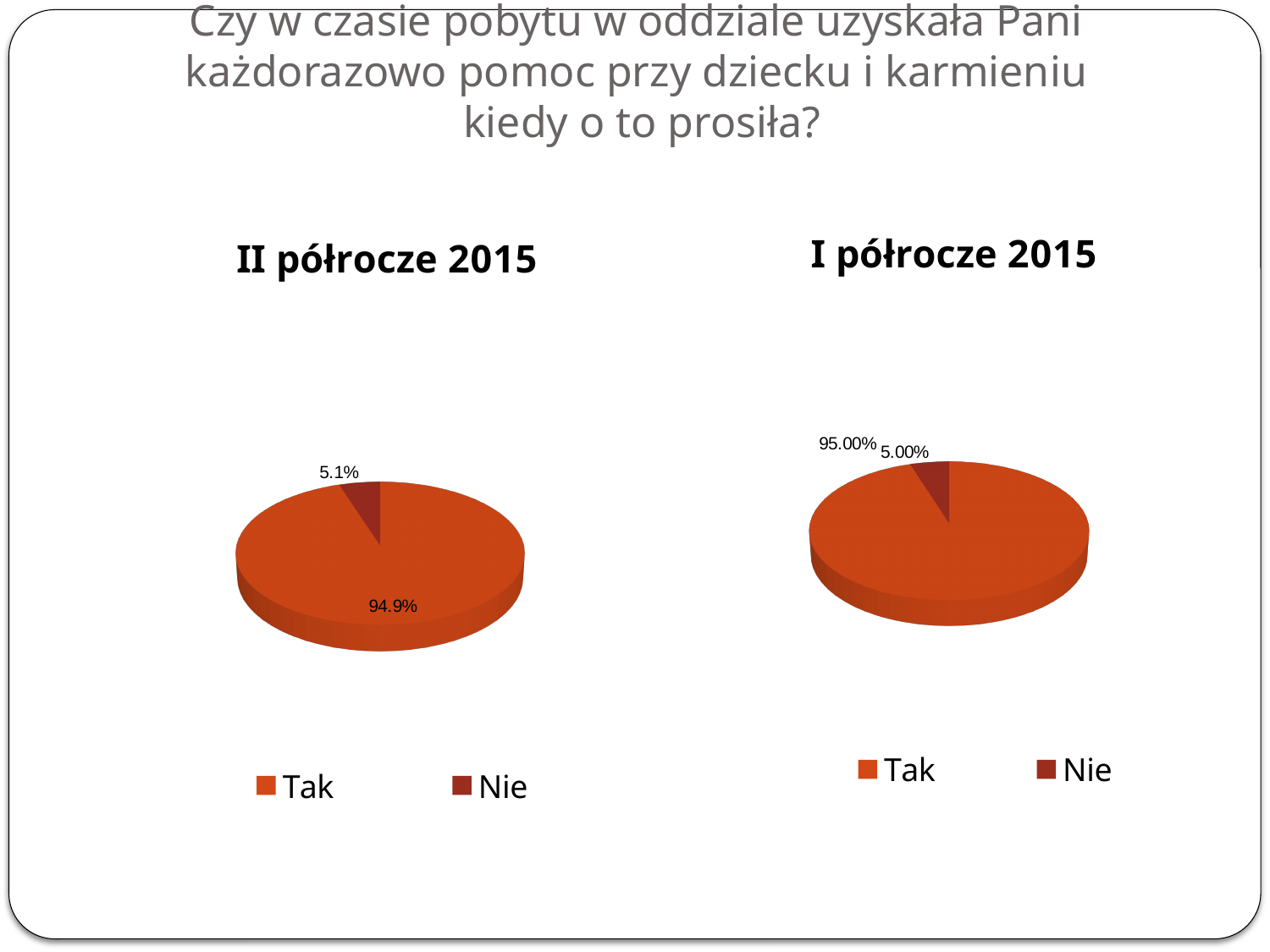
In the 'II półrocze 2015' chart, what is the difference between the Tak and Nie values? 89.8% In the 'II półrocze 2015' chart, what is the value for Tak? 94.9% In the 'I półrocze 2015' chart, which category has the smallest slice? Nie In the 'I półrocze 2015' chart, which is larger, Tak or Nie? Tak In the 'II półrocze 2015' chart, which category has the largest slice? Tak In the 'II półrocze 2015' chart, what colour is the Nie slice? Dark red In the 'I półrocze 2015' chart, what is the difference between the Tak and Nie values? 90.00% What kind of chart is the 'II półrocze 2015' chart? Pie chart In the 'I półrocze 2015' chart, what is the value for Nie? 5.00% In the 'II półrocze 2015' chart, what is the value for Nie? 5.1% In the 'I półrocze 2015' chart, what is the value for Tak? 95.00% How many categories does the legend of the 'I półrocze 2015' chart list? 2